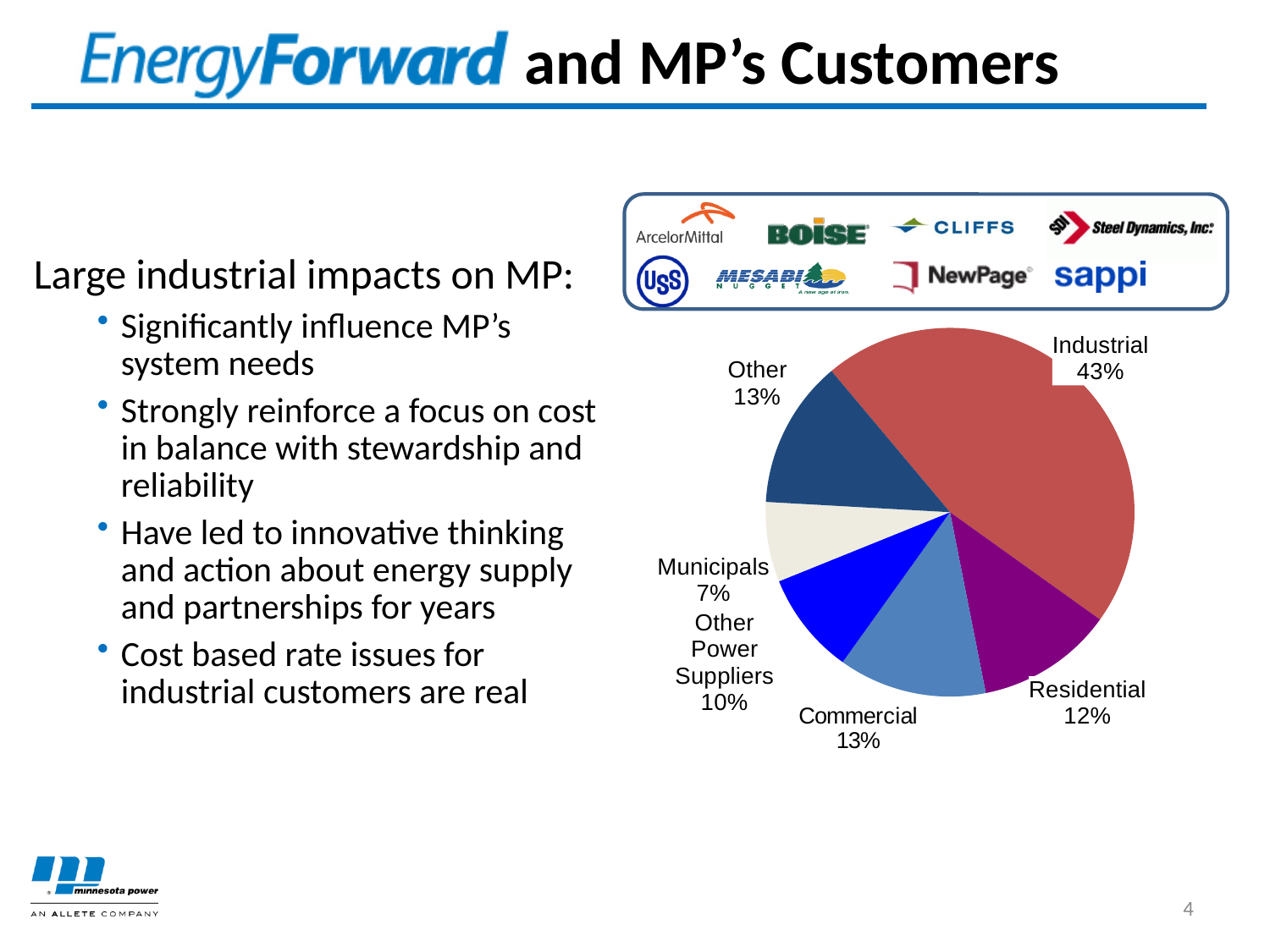
Which category has the largest slice of the pie? Industrial Which category has the smallest slice of the pie? Municipals How many slices does the pie chart have? 6 What is the combined percentage of the Commercial and Residential slices? 25% What percentage is shown for Residential? 12% What percentage is shown for Commercial? 13% What is the difference in percentage points between the Industrial and Residential slices? 31 What share of the pie does the Industrial slice represent? 43% What kind of chart is shown on the slide? pie chart Which is larger, the Other Power Suppliers slice or the Municipals slice? Other Power Suppliers What percentage is shown for Other Power Suppliers? 10% What percentage is shown for Municipals? 7%